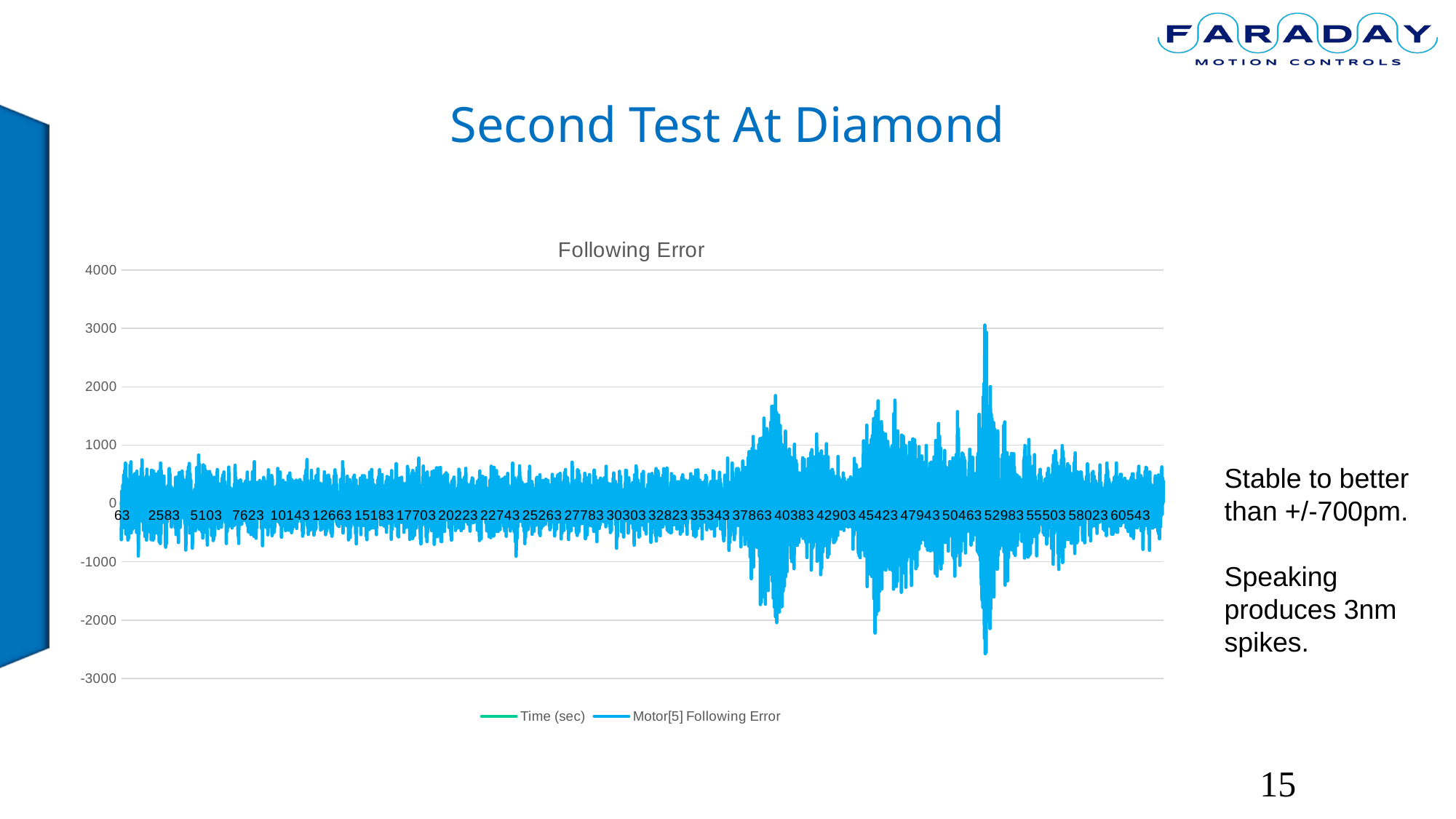
What kind of chart is shown on the slide? line chart What is the title of the chart? Following Error What are the two series names listed in the chart legend? Time (sec) and Motor[5] Following Error Is the largest positive spike of the Motor[5] Following Error series greater or less than 2000? greater What is the lowest value shown on the vertical axis? -3000 Is the largest negative spike of the Motor[5] Following Error series greater or less than -2000? less What is the first label on the horizontal axis? 63 How many labels are printed along the horizontal axis? 25 What is the highest value shown on the vertical axis? 4000 Is the Motor[5] Following Error value at the first x-axis label (63) greater or less than 1000? less How many series does the chart legend list? 2 What is the last label on the horizontal axis? 60543